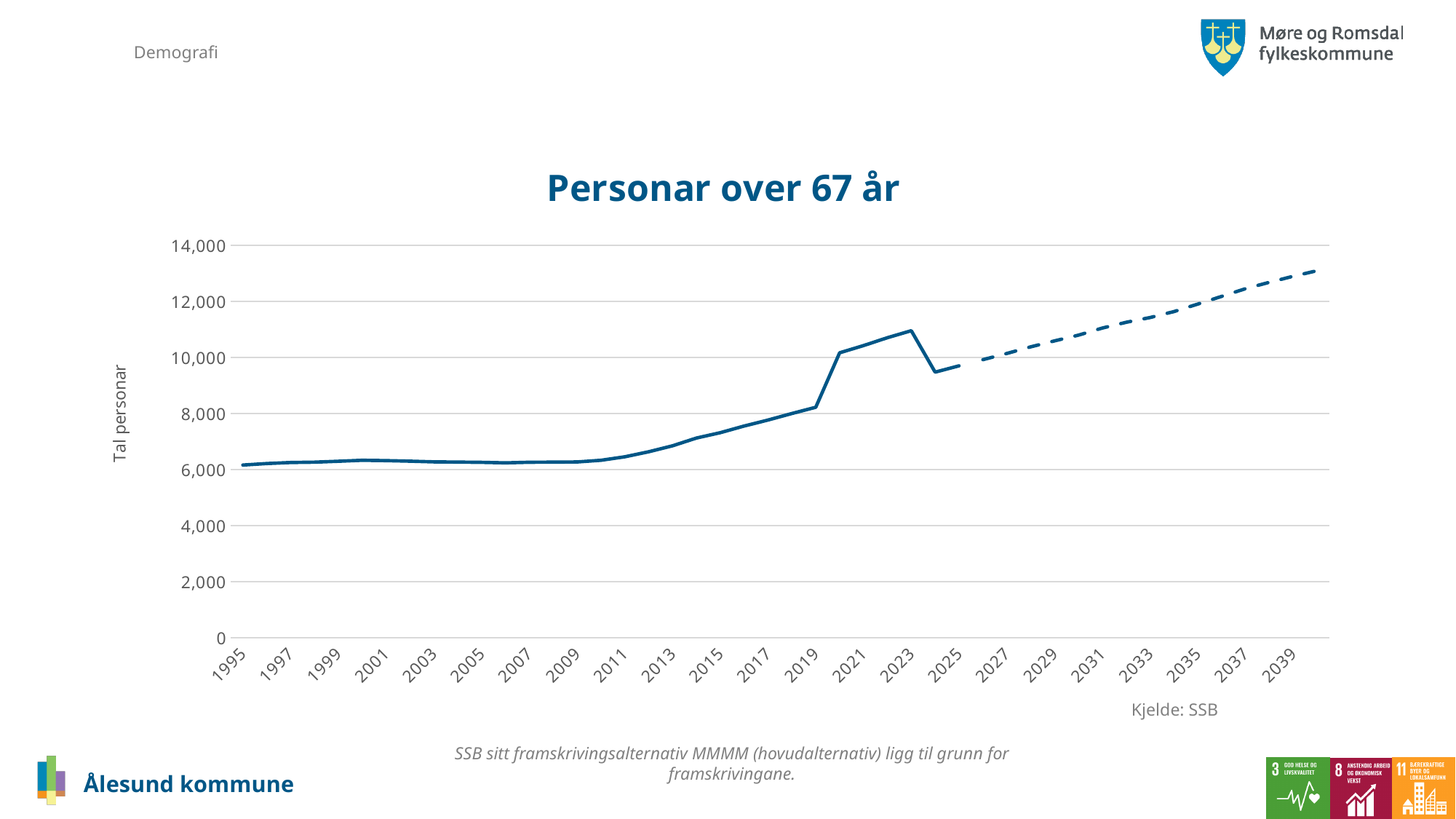
What is the title of the chart? Personar over 67 år Which is larger, the value for 2019 or the value for 2021? 2021 Do the values generally rise or fall from 1995 to 2039? rise Is the value for 2025 greater or less than 10,000? less Is the value for 2039 greater or less than 14,000? less Is the value for 2023 greater or less than 10,000? greater What kind of chart is shown on the slide? line chart Which is larger, the value for 2023 or the value for 2025? 2023 What is the label on the vertical axis of the chart? Tal personar